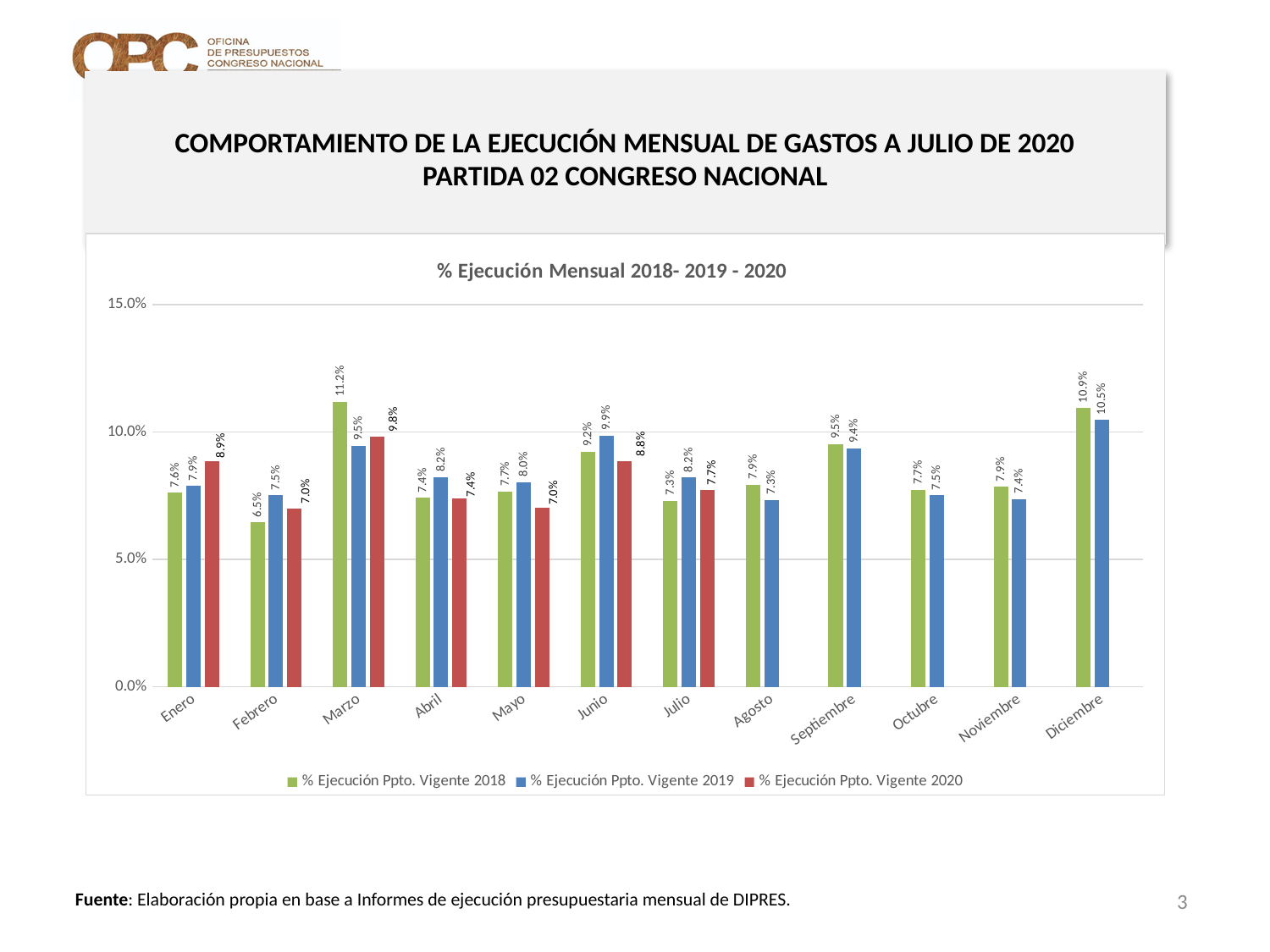
How many months are shown on the x axis? 12 What is the difference between the 2018 and 2019 values for Marzo? 1.7% Which month has the highest value in the % Ejecución Ppto. Vigente 2018 series? Marzo What kind of chart is shown on the slide? Bar chart Which month has the lowest value in the % Ejecución Ppto. Vigente 2018 series? Febrero What is the value for Marzo in the % Ejecución Ppto. Vigente 2018 series? 11.2% How many series does the legend list? 3 What is the value for Enero in the % Ejecución Ppto. Vigente 2020 series? 8.9% What is the value for Diciembre in the % Ejecución Ppto. Vigente 2019 series? 10.5% Which month has the highest value in the % Ejecución Ppto. Vigente 2020 series? Marzo Is the value for Diciembre in the % Ejecución Ppto. Vigente 2018 series greater or less than 10.0%? greater For Junio, which series has the larger value: % Ejecución Ppto. Vigente 2019 or % Ejecución Ppto. Vigente 2020? % Ejecución Ppto. Vigente 2019